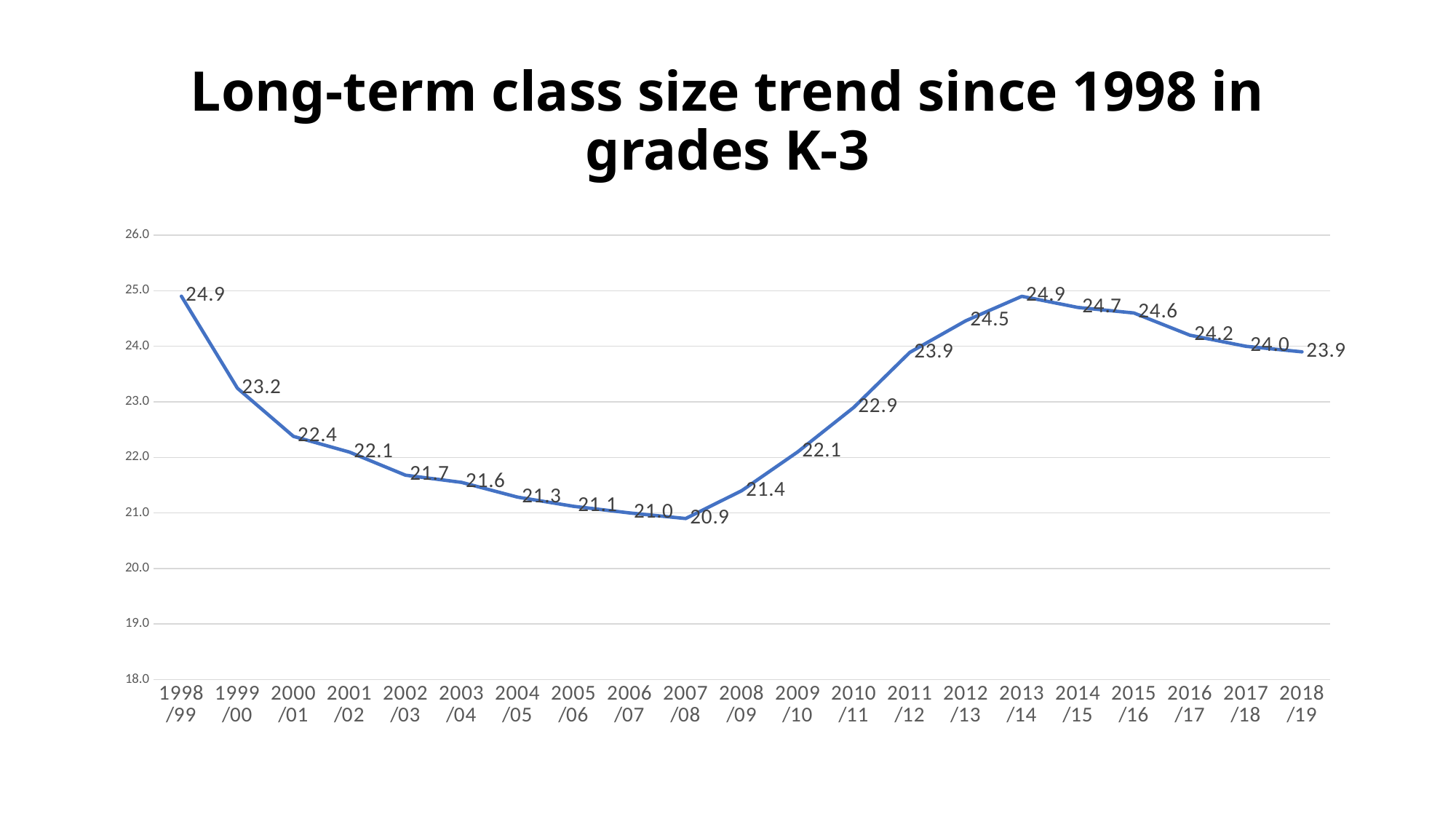
What is the difference between the class size values for 2013/14 and 2007/08? 4.0 How many school years are plotted on the x axis? 21 What is the class size value for 1998/99? 24.9 What type of chart is shown on the slide? line chart Which is larger, the class size value for 2010/11 or for 2016/17? 2016/17 What is the class size value for 2018/19? 23.9 Which school year has the lowest class size value? 2007/08 Do the values rise or fall from 2007/08 to 2013/14? rise What is the class size value for 2007/08? 20.9 What is the class size value for 2011/12? 23.9 What is the title of the chart? Long-term class size trend since 1998 in grades K-3 What is the difference between the class size values for 1998/99 and 1999/00? 1.7